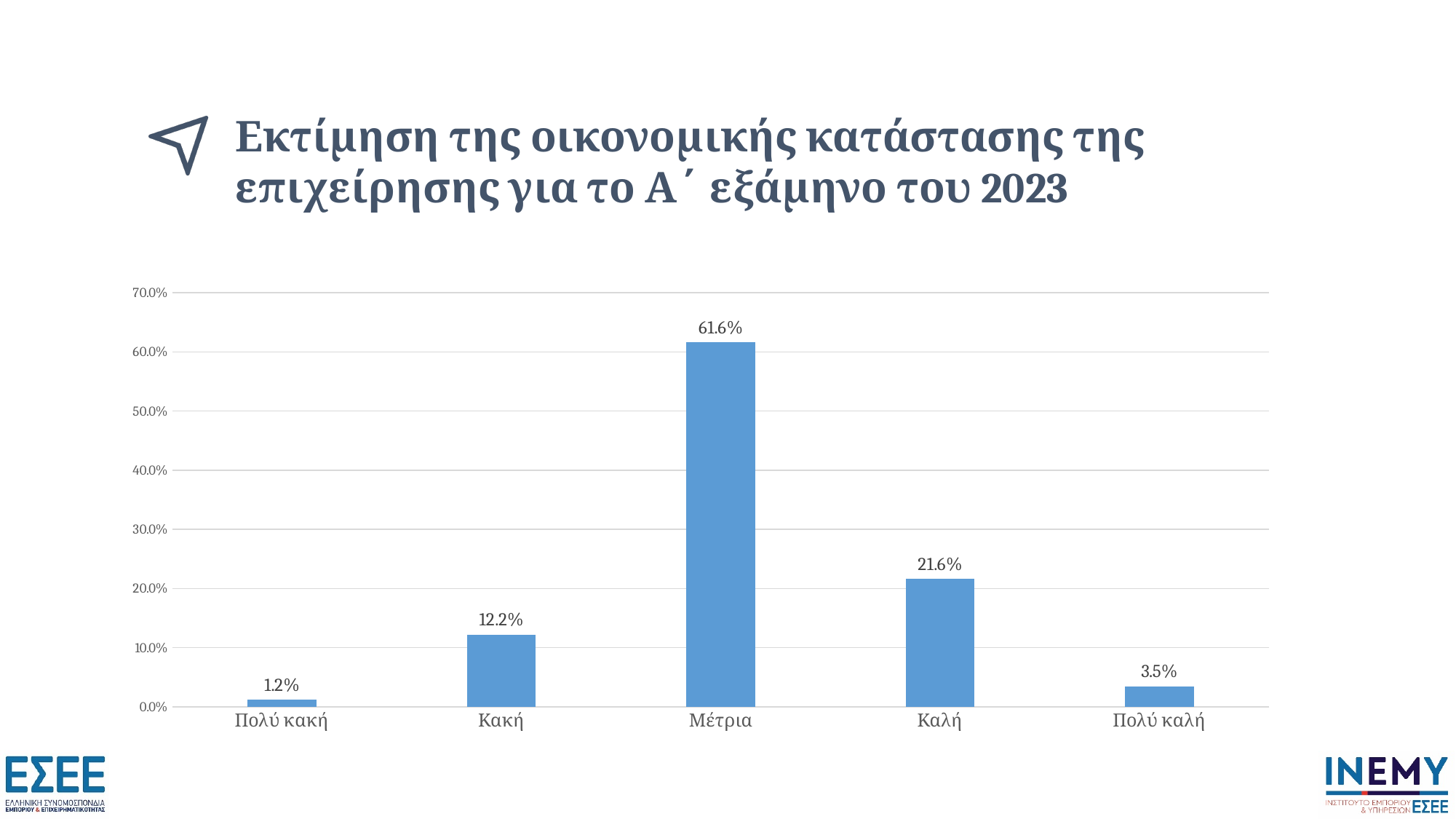
Which is larger, the value for Κακή or the value for Πολύ καλή? Κακή What is the value for Μέτρια? 61.6% What is the value for Καλή? 21.6% What is the value for Πολύ κακή? 1.2% Is the value for Μέτρια greater or less than 60.0%? greater What is the difference between the values for Καλή and Κακή? 9.4% What kind of chart is shown on the slide? bar chart Which category has the lowest value? Πολύ κακή Which category has the highest value? Μέτρια What is the title of the slide? Εκτίμηση της οικονομικής κατάστασης της επιχείρησης για το Α΄ εξάμηνο του 2023 How many categories are shown on the x axis? 5 What is the value for Πολύ καλή? 3.5%